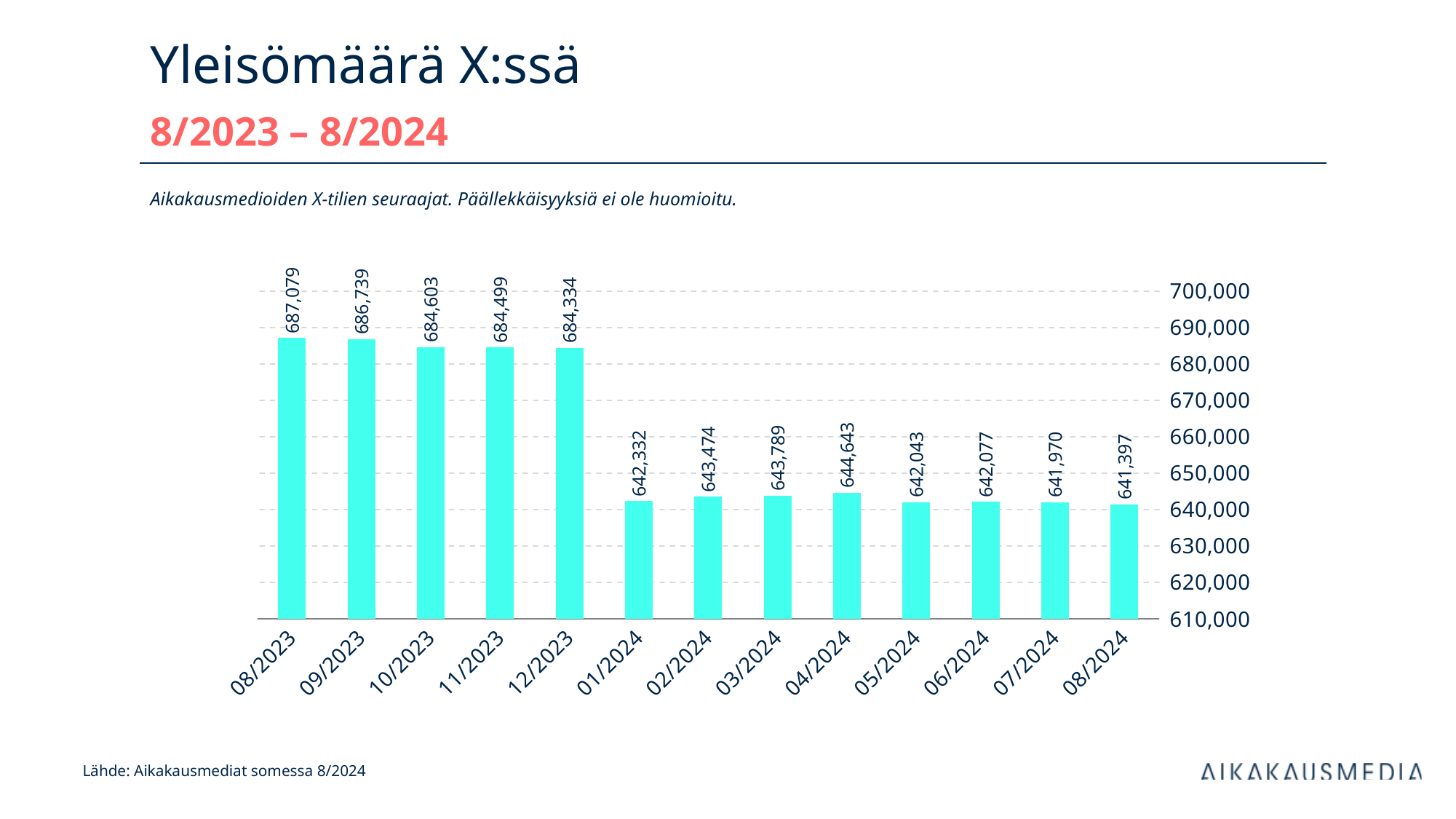
How many months are shown on the x axis? 13 Which month has the highest value? 08/2023 What is the value for 08/2023? 687,079 Which is larger, the value for 12/2023 or the value for 01/2024? 12/2023 Do the values generally rise or fall from 08/2023 to 08/2024? fall Which month has the lowest value? 08/2024 What is the value for 01/2024? 642,332 Is the value for 04/2024 greater or less than 650,000? less What is the title of the chart? Yleisömäärä X:ssä What kind of chart is shown on the slide? bar chart What is the difference between the values for 08/2023 and 08/2024? 45,682 What is the value for 08/2024? 641,397